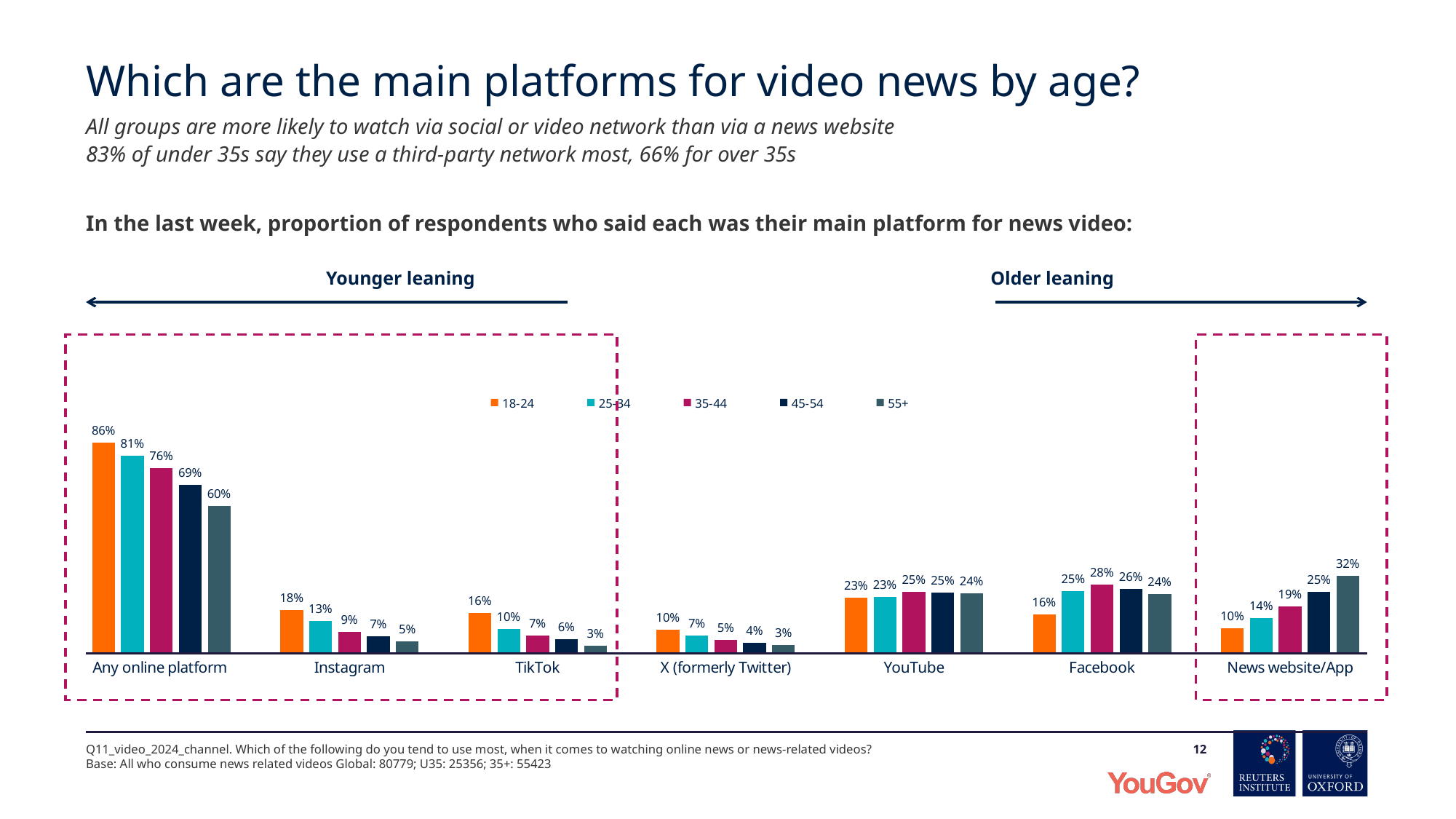
Which age group has the lowest value for News website/App? 18-24 What is the difference between the 18-24 and 55+ values for Any online platform? 26 percentage points What is the value for the 55+ age group for News website/App? 32% Which is larger for the 55+ group: Facebook or News website/App? News website/App How many platform categories are shown on the x axis? 7 Which age group has the highest value for Instagram? 18-24 What is the value for the 25-34 age group for TikTok? 10% What kind of chart is shown on the slide? Bar chart Which platforms are enclosed in the dashed box labelled 'Younger leaning'? Any online platform, Instagram, TikTok How many age groups does the legend list? 5 What percentage of 18-24 year olds said any online platform was their main platform for news video? 86% What is the value for the 35-44 age group for Facebook? 28%